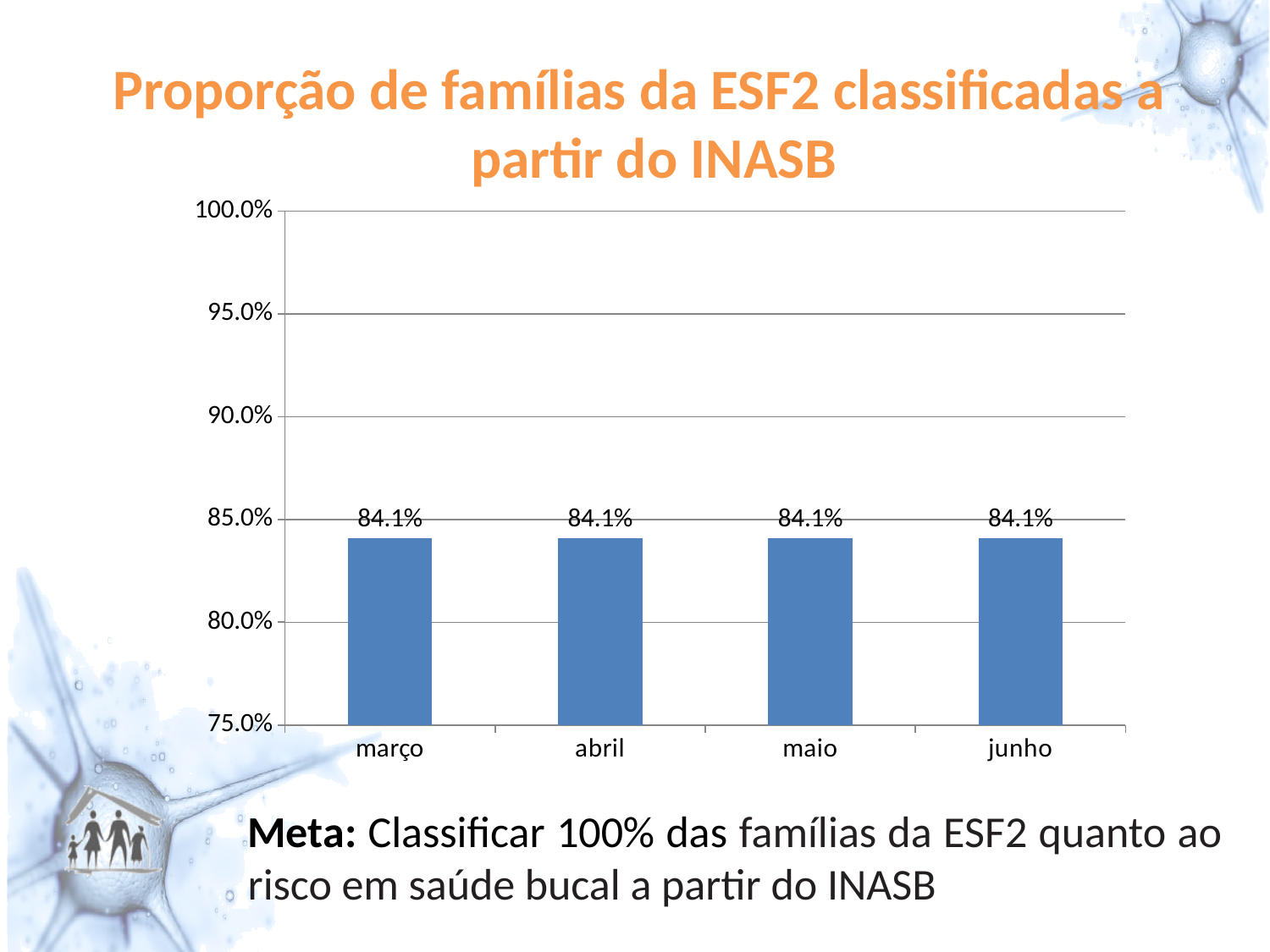
Do the values rise, fall or stay the same from março to junho? stay the same What is the value for abril? 84.1% What is the value for março? 84.1% Is the value for maio greater or less than 85.0%? less What kind of chart is shown on the slide? bar chart Is the value for abril greater or less than 80.0%? greater What is the title of the chart? Proporção de famílias da ESF2 classificadas a partir do INASB What is the value for junho? 84.1% What is the lowest value shown on the y axis? 75.0% How many months are shown on the x axis? 4 What is the difference between the values for maio and março? 0.0%